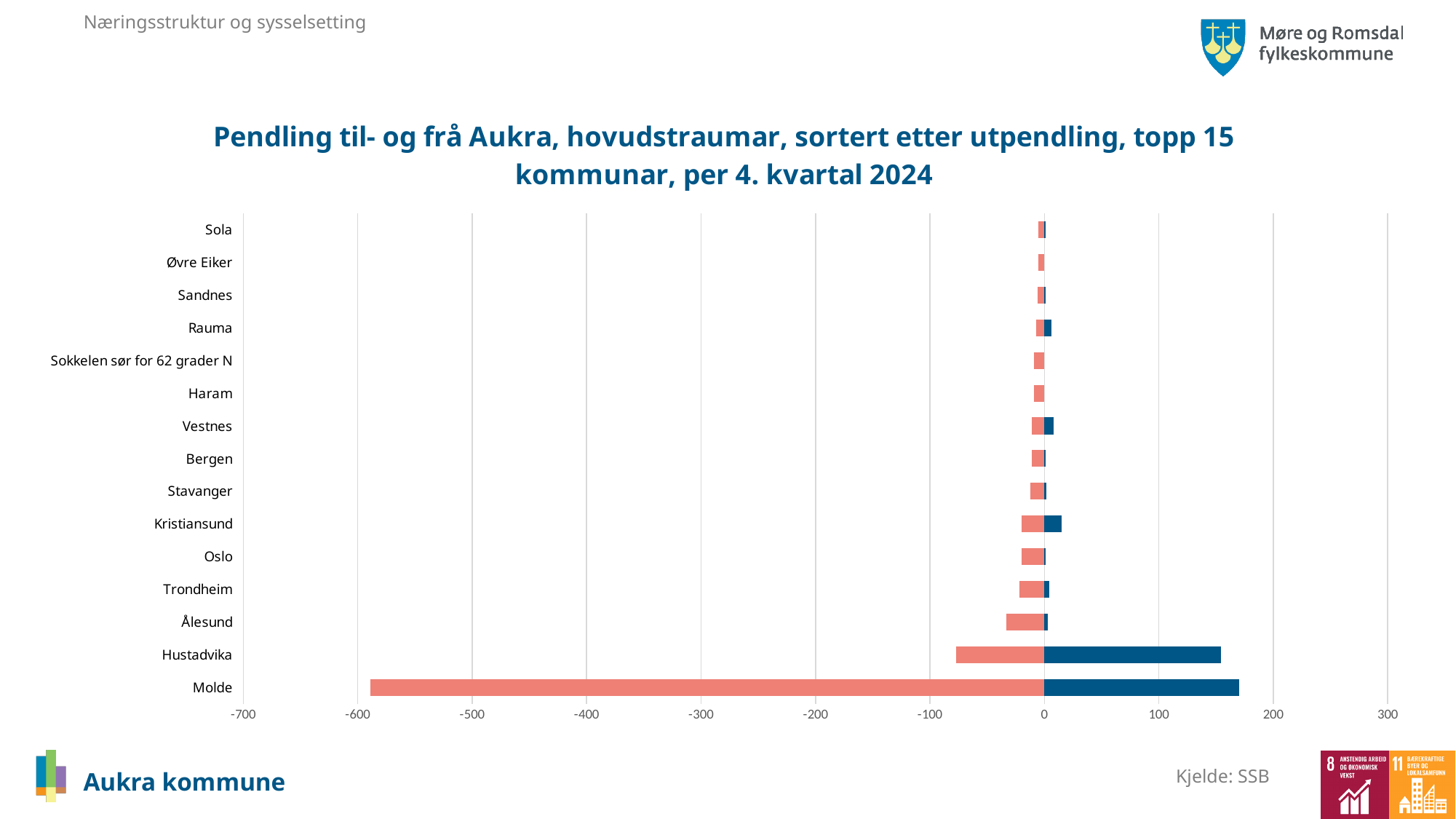
Is the red bar value for Molde greater or less than -500? less Is the blue bar value for Kristiansund greater or less than 100? less What is the source cited for the chart? SSB Is the blue bar value for Hustadvika greater or less than 100? greater Which municipality has the longest red (negative) bar? Molde Which has the longer red bar, Molde or Hustadvika? Molde Which has the longer red bar, Ålesund or Oslo? Ålesund How many municipalities (categories) are listed on the chart? 15 Which has the longer blue bar, Kristiansund or Trondheim? Kristiansund Do the red bars get longer or shorter going from the top of the chart (Sola) down to the bottom (Molde)? longer What kind of chart is shown on the slide? bar chart